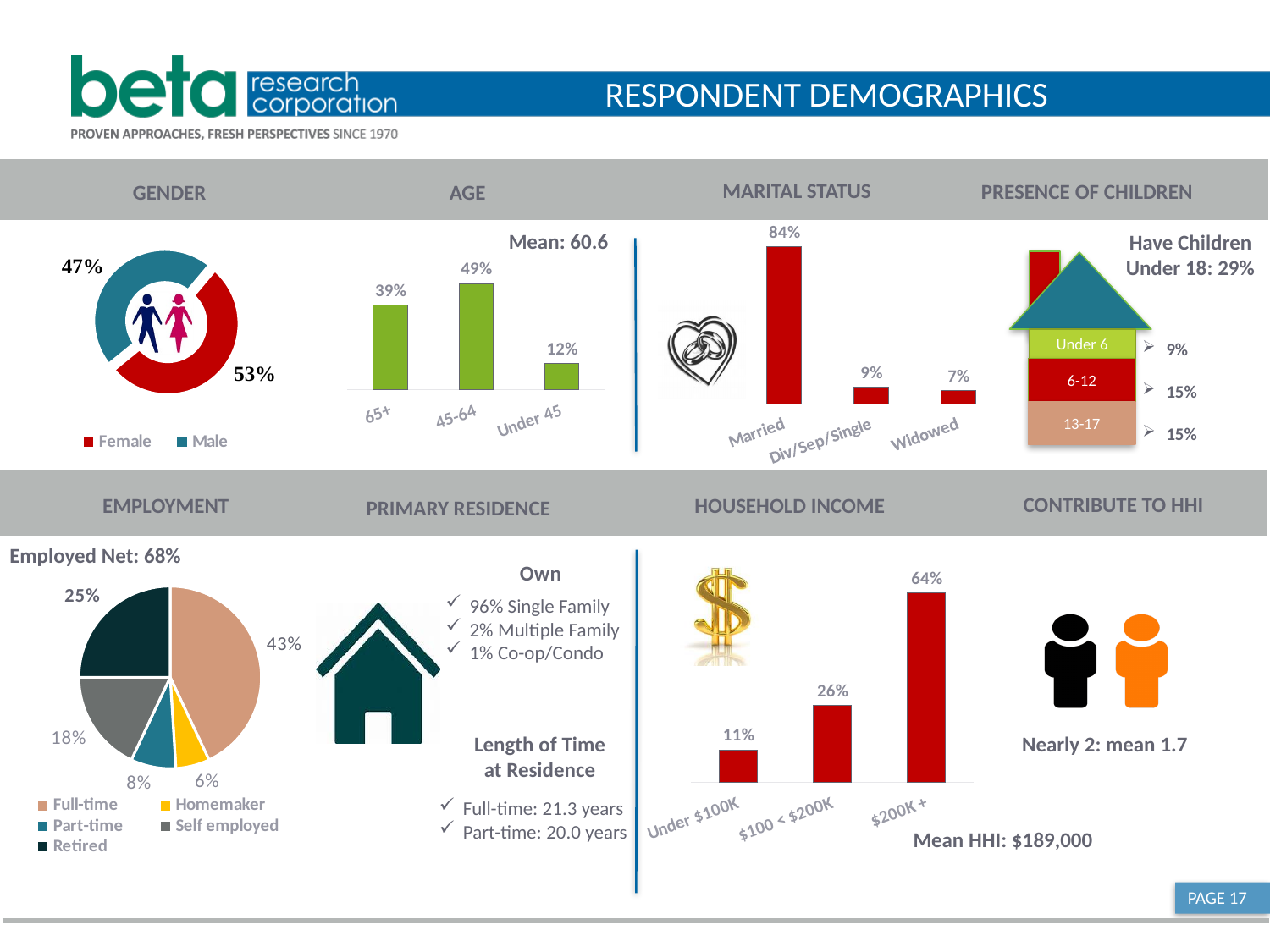
In the Employment chart, what percentage of respondents are Retired? 25% In the Gender chart, what percentage of respondents are Female? 53% In the Marital Status chart, what percentage of respondents are Married? 84% In the Household Income chart, what percentage of respondents earn $200K+? 64% In the Age chart, what percentage of respondents are 45-64? 49% In the Gender chart, what percentage of respondents are Male? 47% In the Age chart, what is the difference between the 45-64 and 65+ percentages? 10% In the Marital Status chart, how many categories are shown? 3 In the Employment chart, which category has the largest share? Full-time In the Age chart, which age group has the lowest percentage? Under 45 What kind of chart is the Household Income chart? Bar chart In the Marital Status chart, which category has the highest percentage? Married